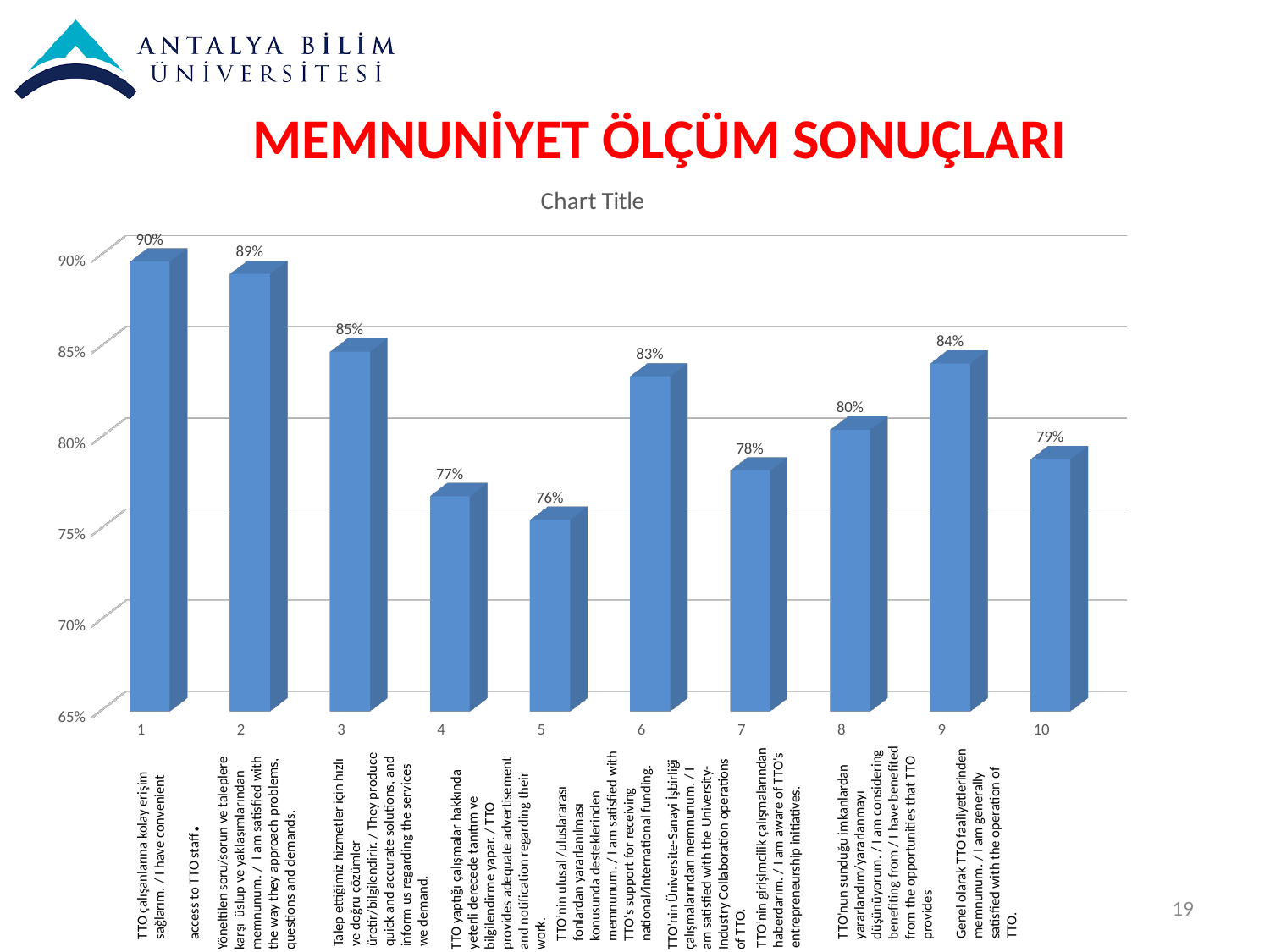
Is the value for category 4 greater or less than 80%? less What is the difference between the values for category 6 and category 7? 5% How many categories are shown on the chart? 10 What is the difference between the values for category 1 and category 5? 14% What is the value for category 5? 76% What is the value for category 10? 79% Which is larger, the value for category 3 or the value for category 8? category 3 Which category has the lowest value? 5 What is the value for category 9? 84% What is the value for category 1? 90% What kind of chart is shown on the slide? bar chart Which category has the highest value? 1